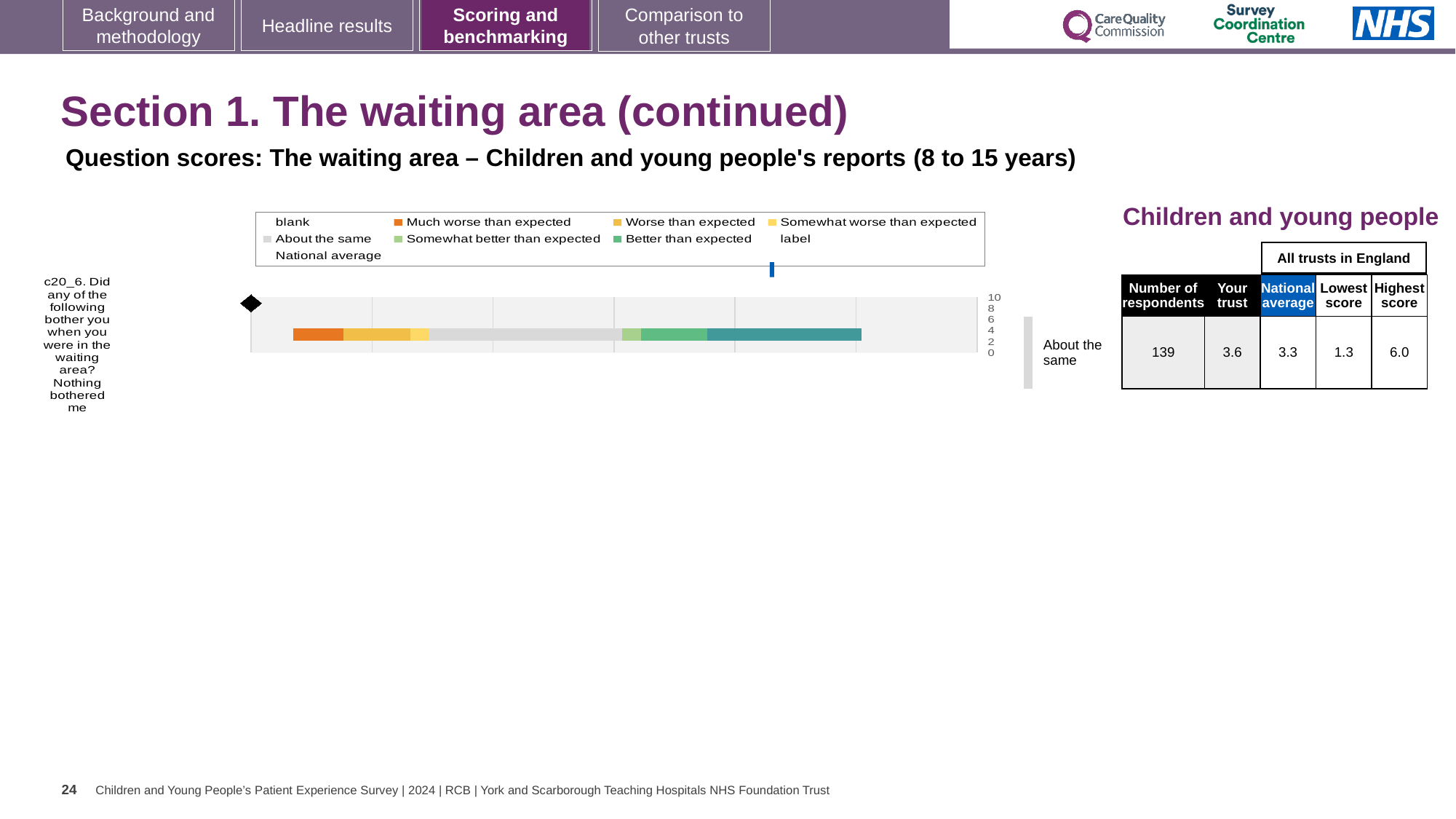
In the table, what is the lowest score among all trusts in England for c20_6? 1.3 What kind of chart is shown on the slide? bar chart How many questions (categories) are plotted in the bar chart? 1 In the table, what is the national average score for c20_6? 3.3 How many respondents are listed in the table for c20_6? 139 What is the difference between the highest score and the lowest score for c20_6 in the table? 4.7 In the table, what is the 'Your trust' score for c20_6? 3.6 According to the label next to the chart, how is the trust's result for c20_6 categorised? About the same Which question is plotted in the bar chart? c20_6. Did any of the following bother you when you were in the waiting area? Nothing bothered me Which is larger for c20_6: the 'Your trust' score or the national average? Your trust What is the difference between the 'Your trust' score and the national average for c20_6? 0.3 In the table, what is the highest score among all trusts in England for c20_6? 6.0